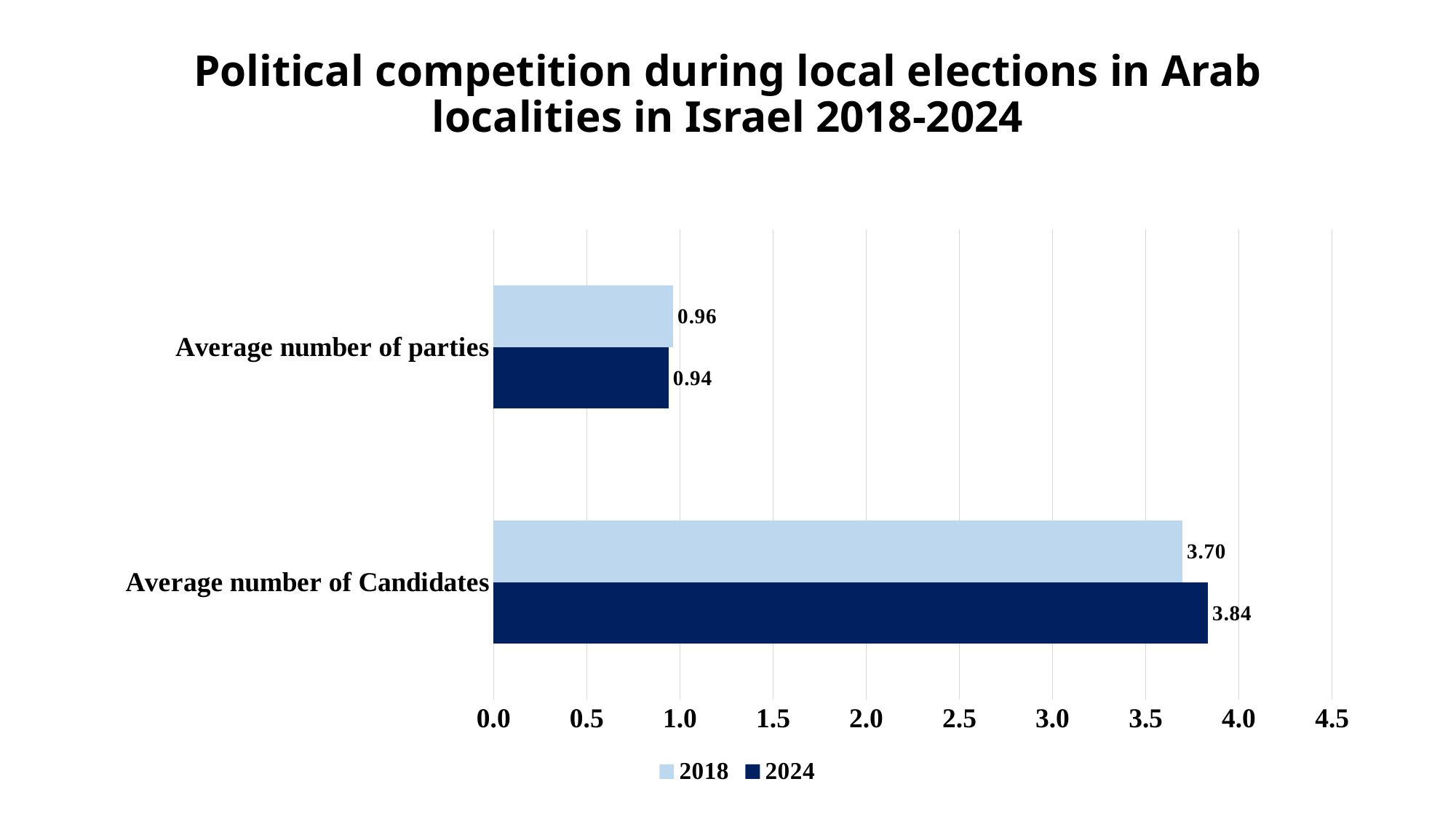
What is the average number of Candidates in 2018? 3.70 What is the difference between the 2018 and 2024 values for Average number of parties? 0.02 What kind of chart is shown on the slide? Bar chart Which category has the highest value in the 2024 series? Average number of Candidates What is the average number of Candidates in 2024? 3.84 What is the average number of parties in 2018? 0.96 How many series does the legend list? 2 Which category has the lowest value in the 2018 series? Average number of parties What is the average number of parties in 2024? 0.94 What is the difference between the 2024 and 2018 values for Average number of Candidates? 0.14 Is the 2024 value for Average number of Candidates greater or less than 3.5? greater How many categories are shown on the chart? 2